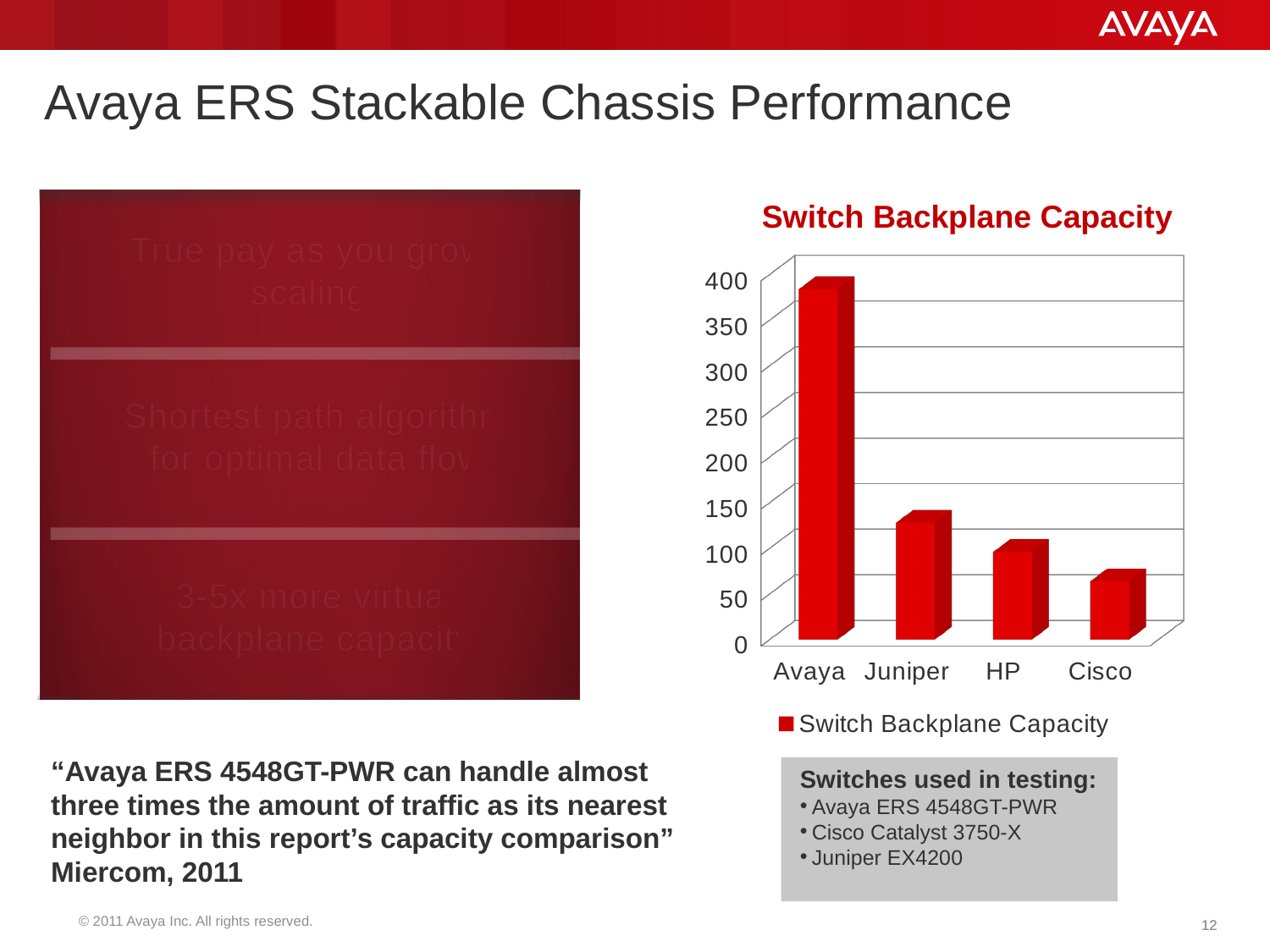
Is the Switch Backplane Capacity for Avaya greater or less than 350? greater Which vendor has the lowest Switch Backplane Capacity? Cisco Is the Switch Backplane Capacity for HP greater or less than 50? greater Which vendor has the highest Switch Backplane Capacity? Avaya Do the values in the Switch Backplane Capacity chart rise or fall from left to right along the x axis? fall What is the title of the chart on the slide? Switch Backplane Capacity How many series does the legend of the Switch Backplane Capacity chart list? 1 How many switch vendors are shown on the x axis of the Switch Backplane Capacity chart? 4 Which has a larger Switch Backplane Capacity, Juniper or HP? Juniper Is the Switch Backplane Capacity for Cisco greater or less than 100? less What kind of chart is the Switch Backplane Capacity chart? bar chart